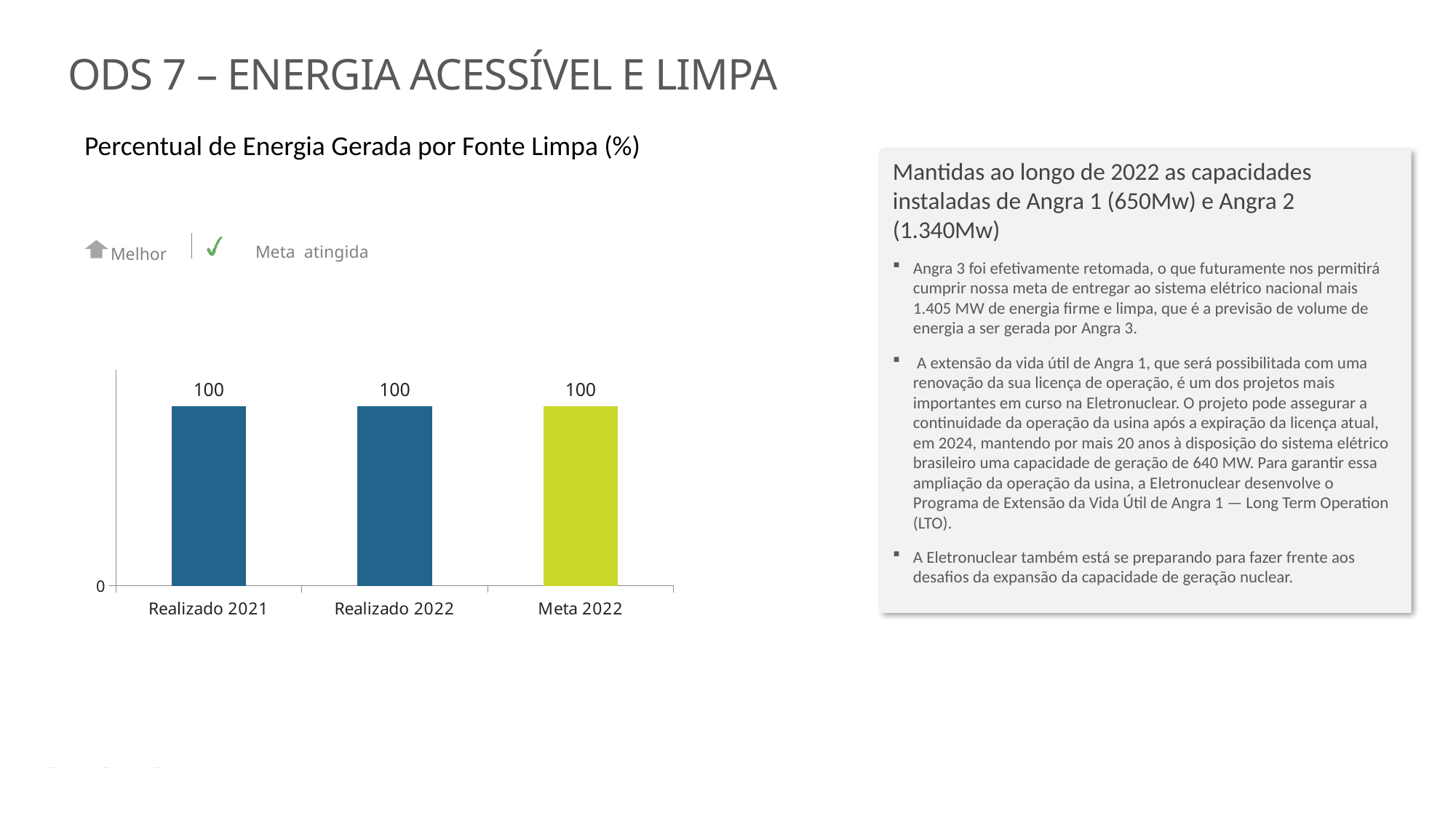
Which bar is shown in a different colour (yellow-green) from the others? Meta 2022 What is the title of the chart? Percentual de Energia Gerada por Fonte Limpa (%) Is the value for Realizado 2021 greater or less than 0? greater What is the value for Realizado 2022? 100 Do the values rise, fall or stay the same from Realizado 2021 to Meta 2022? stay the same What is the difference between the values for Realizado 2021 and Realizado 2022? 0 What kind of chart is shown on the slide? bar chart How many categories are shown on the x axis of the chart? 3 What is the value for Meta 2022? 100 What is the value for Realizado 2021? 100 What is the difference between the values for Realizado 2022 and Meta 2022? 0